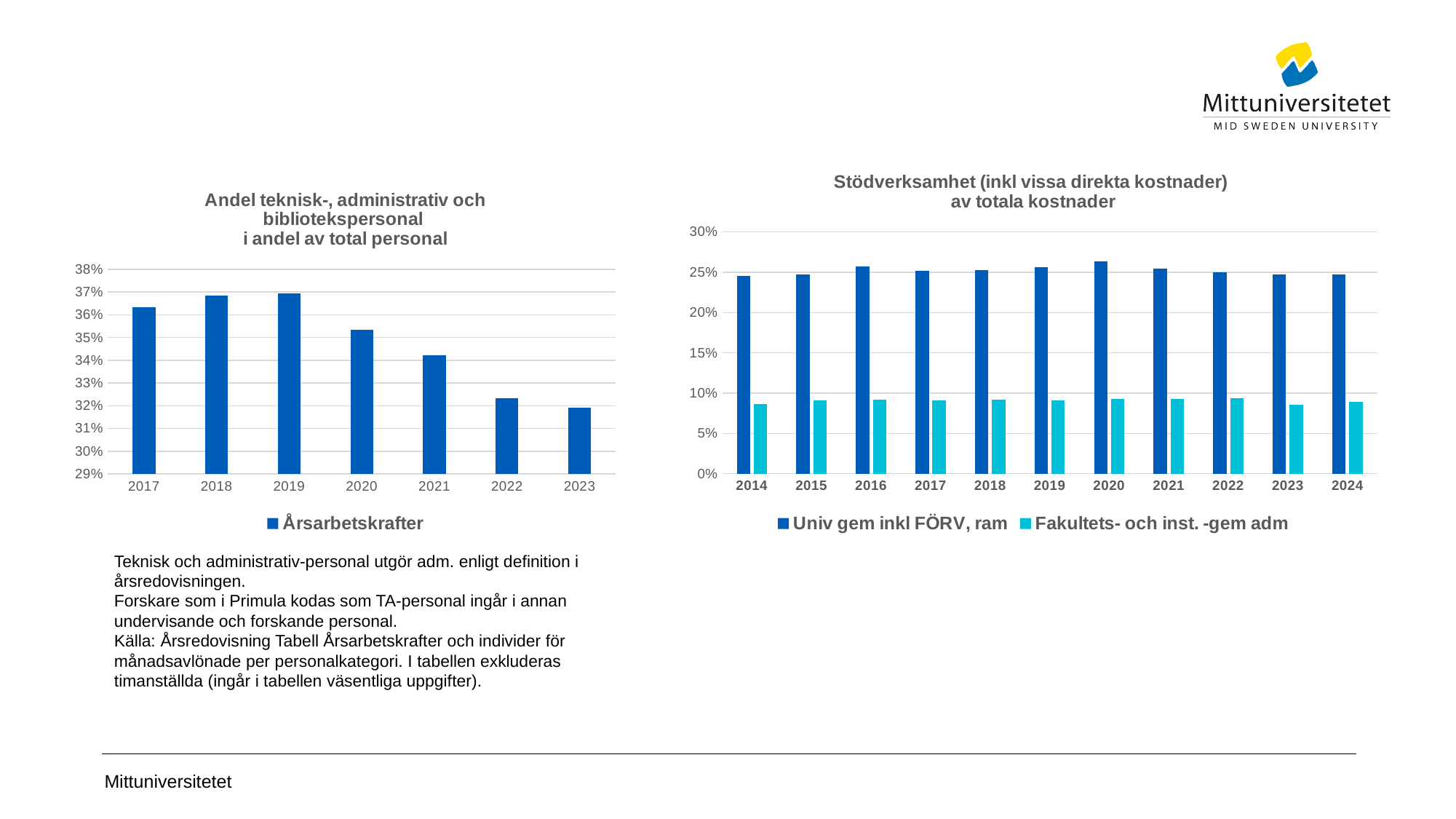
What kind of chart is the left chart, 'Andel teknisk-, administrativ och bibliotekspersonal i andel av total personal'? Bar chart In the right chart, 'Stödverksamhet (inkl vissa direkta kostnader) av totala kostnader', is the value for 'Fakultets- och inst. -gem adm' in 2014 greater or less than 10%? less In the left chart, 'Andel teknisk-, administrativ och bibliotekspersonal i andel av total personal', is the value for 2017 greater or less than 36%? greater How many years are shown on the x axis of the right chart, 'Stödverksamhet (inkl vissa direkta kostnader) av totala kostnader'? 11 How many years are shown on the x axis of the left chart, 'Andel teknisk-, administrativ och bibliotekspersonal i andel av total personal'? 7 In the left chart, 'Andel teknisk-, administrativ och bibliotekspersonal i andel av total personal', is the value for 2021 greater or less than 35%? less In the left chart, 'Andel teknisk-, administrativ och bibliotekspersonal i andel av total personal', do the values generally rise or fall from 2019 to 2023? Fall What is the name of the series shown in the legend of the left chart, 'Andel teknisk-, administrativ och bibliotekspersonal i andel av total personal'? Årsarbetskrafter In the left chart, 'Andel teknisk-, administrativ och bibliotekspersonal i andel av total personal', which year has the lowest value? 2023 In the left chart, 'Andel teknisk-, administrativ och bibliotekspersonal i andel av total personal', which is larger, the value for 2018 or the value for 2022? 2018 How many series does the legend of the right chart, 'Stödverksamhet (inkl vissa direkta kostnader) av totala kostnader', list? 2 In the right chart, 'Stödverksamhet (inkl vissa direkta kostnader) av totala kostnader', which year has the highest value for 'Univ gem inkl FÖRV, ram'? 2020